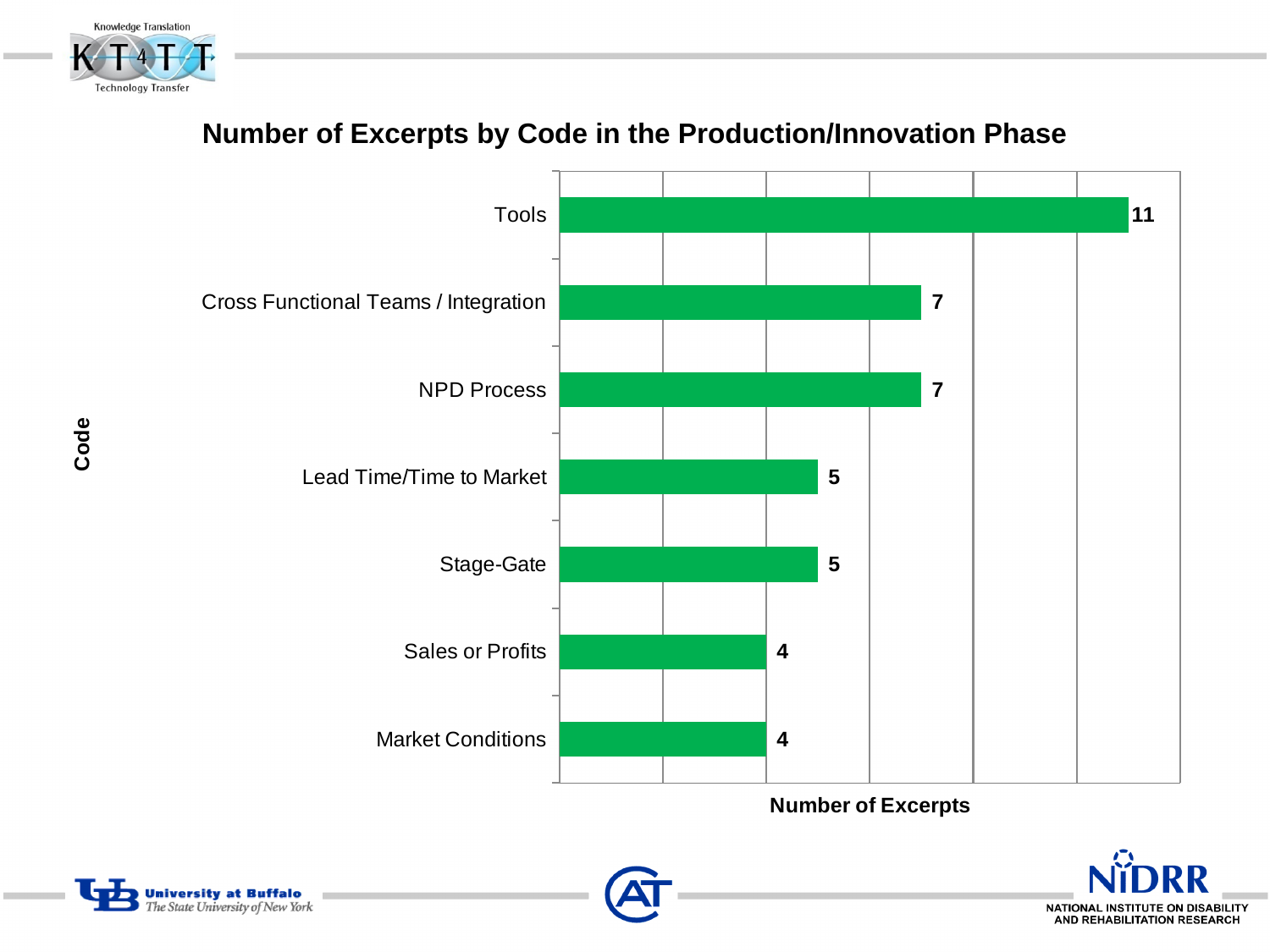
How many codes are shown in the chart? 7 What is the label of the horizontal axis? Number of Excerpts What is the difference in number of excerpts between Lead Time/Time to Market and Sales or Profits? 1 What is the number of excerpts for Tools? 11 What is the number of excerpts for Market Conditions? 4 What kind of chart is shown on the slide? Bar chart What is the title of the chart? Number of Excerpts by Code in the Production/Innovation Phase Which code has the highest number of excerpts? Tools What is the number of excerpts for Cross Functional Teams / Integration? 7 What is the number of excerpts for Stage-Gate? 5 Which has more excerpts, Cross Functional Teams / Integration or Stage-Gate? Cross Functional Teams / Integration What is the difference in number of excerpts between Tools and NPD Process? 4